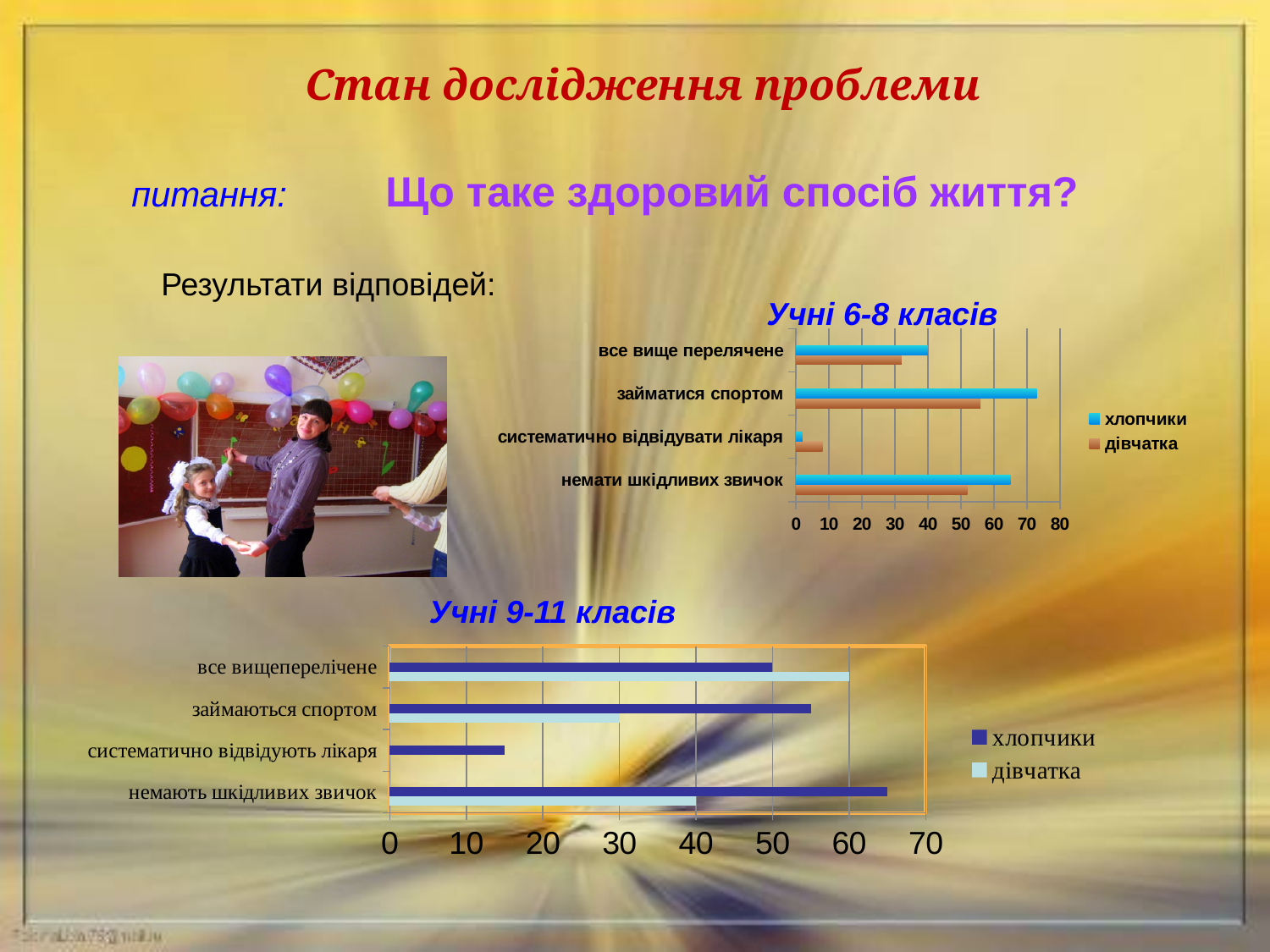
How many categories are shown in the "Учні 6-8 класів" chart? 4 In the "Учні 9-11 класів" chart, which category has the highest value for хлопчики? немають шкідливих звичок In the "Учні 6-8 класів" chart, which is larger for "все вище перелячене": хлопчики or дівчатка? хлопчики In the "Учні 9-11 класів" chart, which series is shown in light blue? дівчатка In the "Учні 9-11 класів" chart, is the value for хлопчики in "систематично відвідують лікаря" greater or less than 20? less In the "Учні 6-8 класів" chart, which category has the lowest value for дівчатка? систематично відвідувати лікаря In the "Учні 9-11 класів" chart, which is larger for "займаються спортом": хлопчики or дівчатка? хлопчики In the "Учні 6-8 класів" chart, is the value for хлопчики in "займатися спортом" greater or less than 70? greater What kind of chart is the "Учні 6-8 класів" chart? bar chart In the "Учні 6-8 класів" chart, which category has the highest value for хлопчики? займатися спортом How many series does the legend of the "Учні 9-11 класів" chart list? 2 In the "Учні 6-8 класів" chart, is the value for дівчатка in "немати шкідливих звичок" greater or less than 60? less